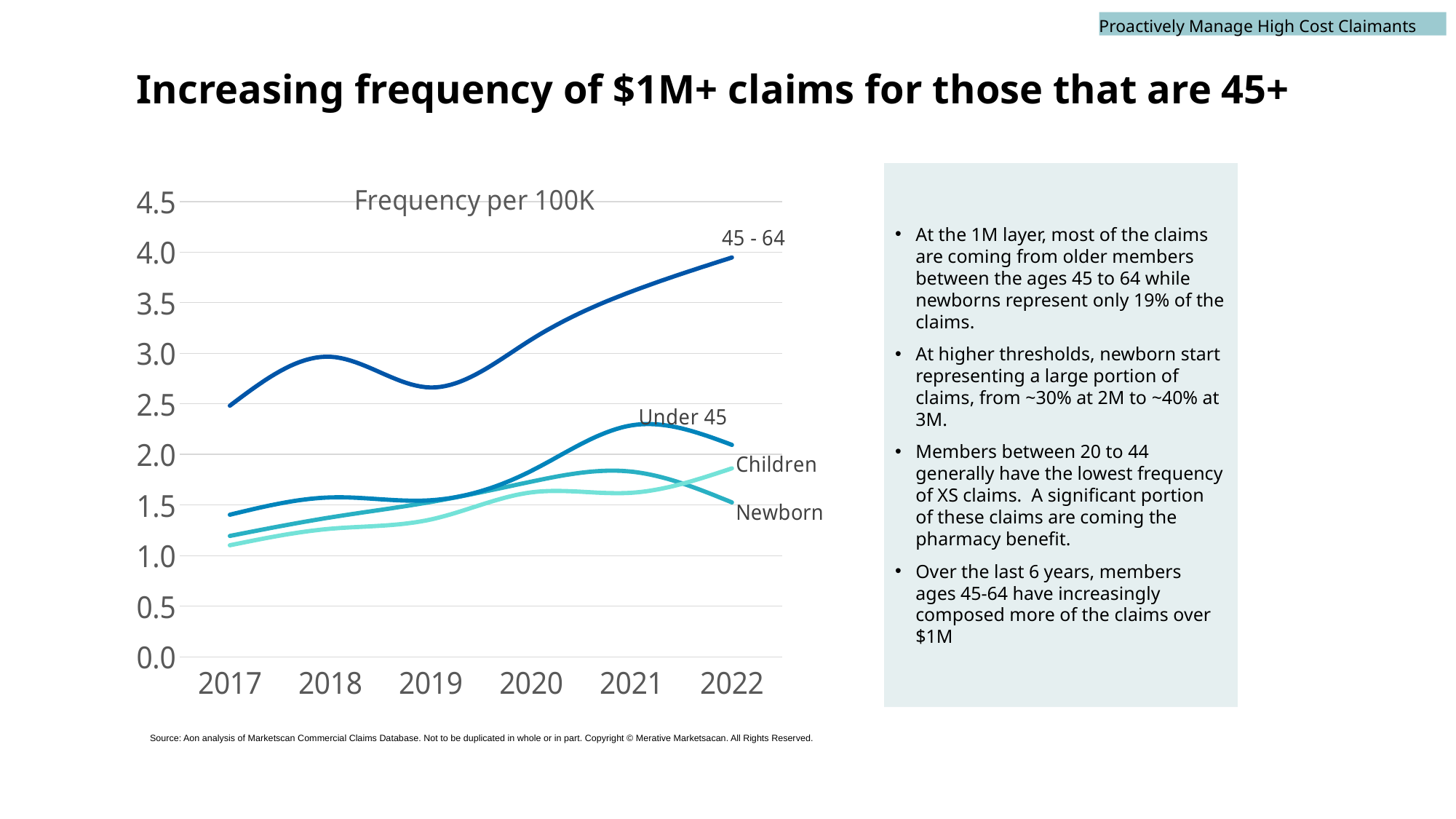
What is the title of the chart? Frequency per 100K How many lines (series) are plotted on the chart? 4 Does the Under 45 line rise or fall from 2021 to 2022? fall Is the value for 45 - 64 in 2022 greater or less than 3.5? greater Which series has the lowest value in 2017? Children Does the 45 - 64 line rise or fall from 2019 to 2022? rise Is the value for 45 - 64 in 2017 greater or less than 3.0? less What kind of chart is shown on the slide? line chart In 2022, which is larger: the value for Under 45 or the value for Children? Under 45 Is the value for Newborn in 2022 greater or less than 2.0? less How many years are shown along the x axis of the chart? 6 Which series has the highest value in 2022? 45 - 64